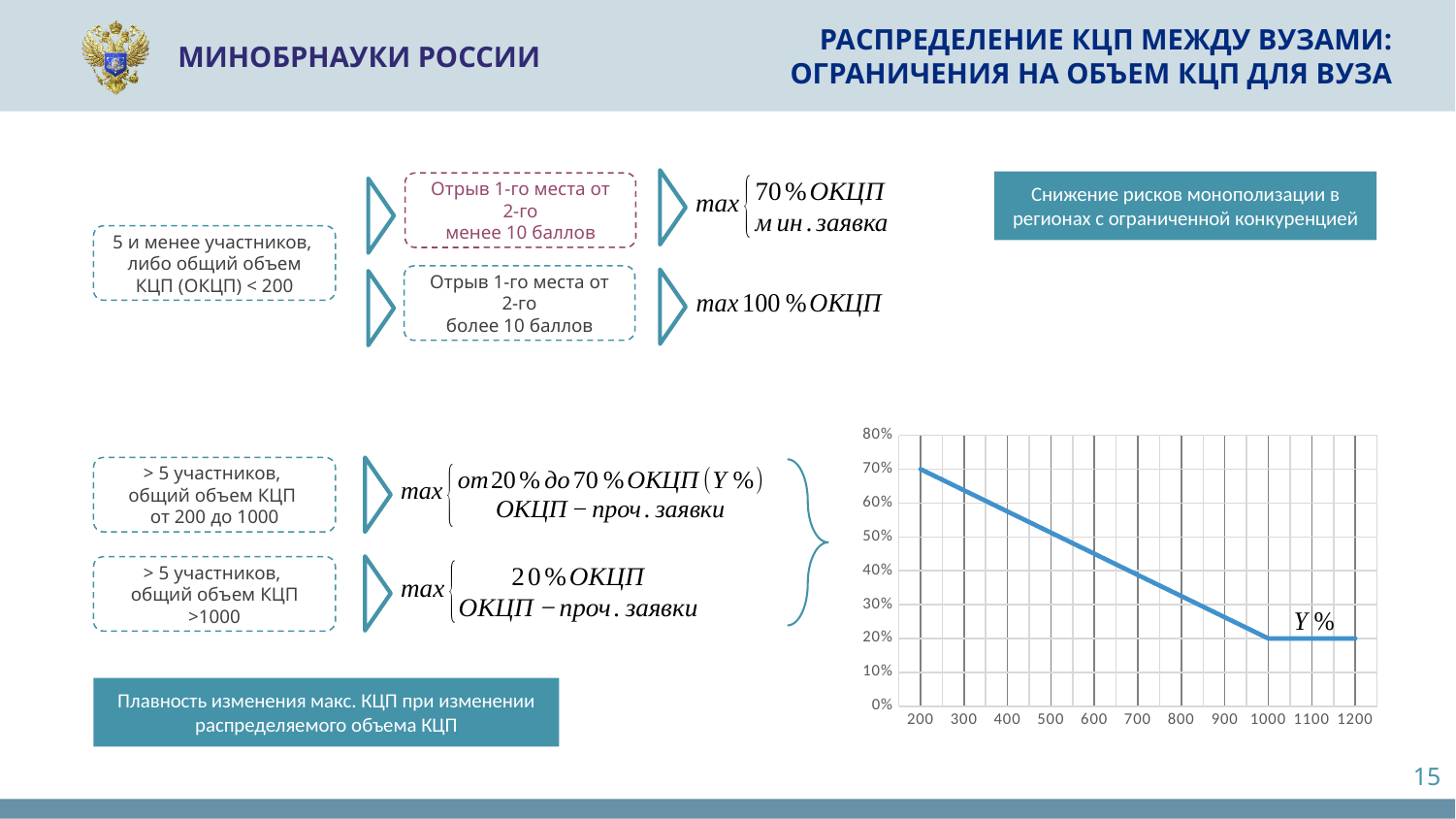
In the chart at the bottom right, does the line rise or fall as x goes from 200 to 1000? fall In the chart at the bottom right, at which x value is the line highest? 200 How many tick labels are shown on the x axis of the chart at the bottom right? 11 In the chart at the bottom right, what is the value of the line at x = 200? 70% In the chart at the bottom right, what is the difference between the value at x = 200 and the value at x = 1000? 50% In the chart at the bottom right, what is the value of the line at x = 1200? 20% In the chart at the bottom right, which is larger: the value at x = 400 or the value at x = 800? x = 400 In the chart at the bottom right, is the value of the line at x = 400 greater or less than 50%? greater In the chart at the bottom right, what is the value of the line at x = 1000? 20% In the chart at the bottom right, is the value of the line at x = 800 greater or less than 40%? less What kind of chart is shown at the bottom right of the slide? line chart What text label is placed next to the flat part of the line in the chart at the bottom right? Y %